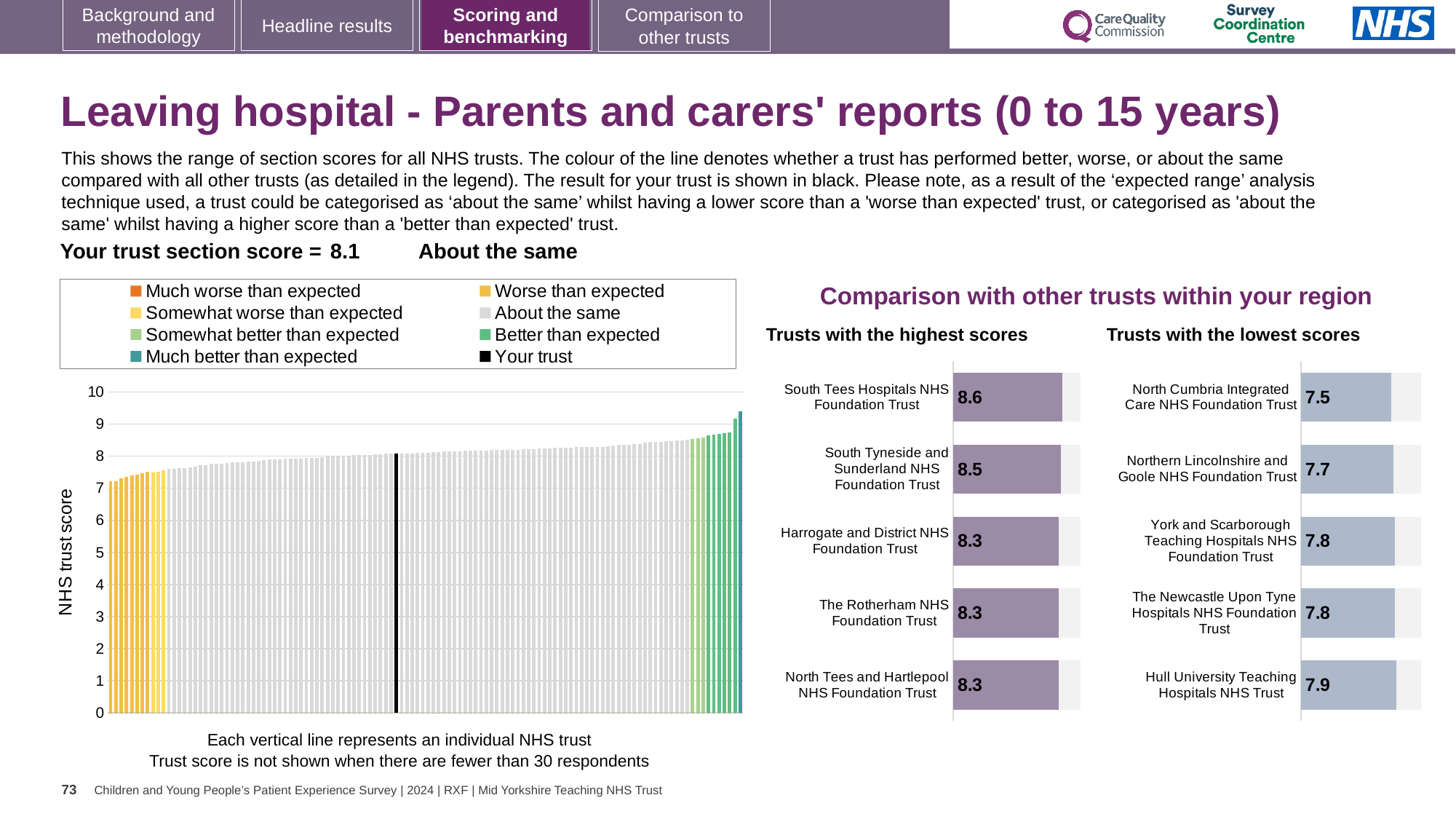
In the 'Trusts with the lowest scores' chart, which has the higher score: Northern Lincolnshire and Goole NHS Foundation Trust or Hull University Teaching Hospitals NHS Trust? Hull University Teaching Hospitals NHS Trust In the 'Trusts with the highest scores' chart, what is the difference between the scores of South Tees Hospitals NHS Foundation Trust and The Rotherham NHS Foundation Trust? 0.3 How many trusts are shown in the 'Trusts with the highest scores' chart? 5 In the 'Trusts with the highest scores' chart, what is the score for Harrogate and District NHS Foundation Trust? 8.3 In the 'Trusts with the highest scores' chart, what is the score for South Tees Hospitals NHS Foundation Trust? 8.6 In the 'Trusts with the lowest scores' chart, what is the score for North Cumbria Integrated Care NHS Foundation Trust? 7.5 In the large chart on the left showing the range of section scores, is the value for the highest-scoring trust (the rightmost bar) greater or less than 9? greater In the 'Trusts with the lowest scores' chart, what is the difference between the scores of Hull University Teaching Hospitals NHS Trust and North Cumbria Integrated Care NHS Foundation Trust? 0.4 In the 'Trusts with the lowest scores' chart, what is the score for Hull University Teaching Hospitals NHS Trust? 7.9 In the 'Trusts with the lowest scores' chart, which trust has the lowest score? North Cumbria Integrated Care NHS Foundation Trust In the large chart on the left, do the trust scores rise or fall from left to right along the x axis? rise In the 'Trusts with the highest scores' chart, which trust has the highest score? South Tees Hospitals NHS Foundation Trust